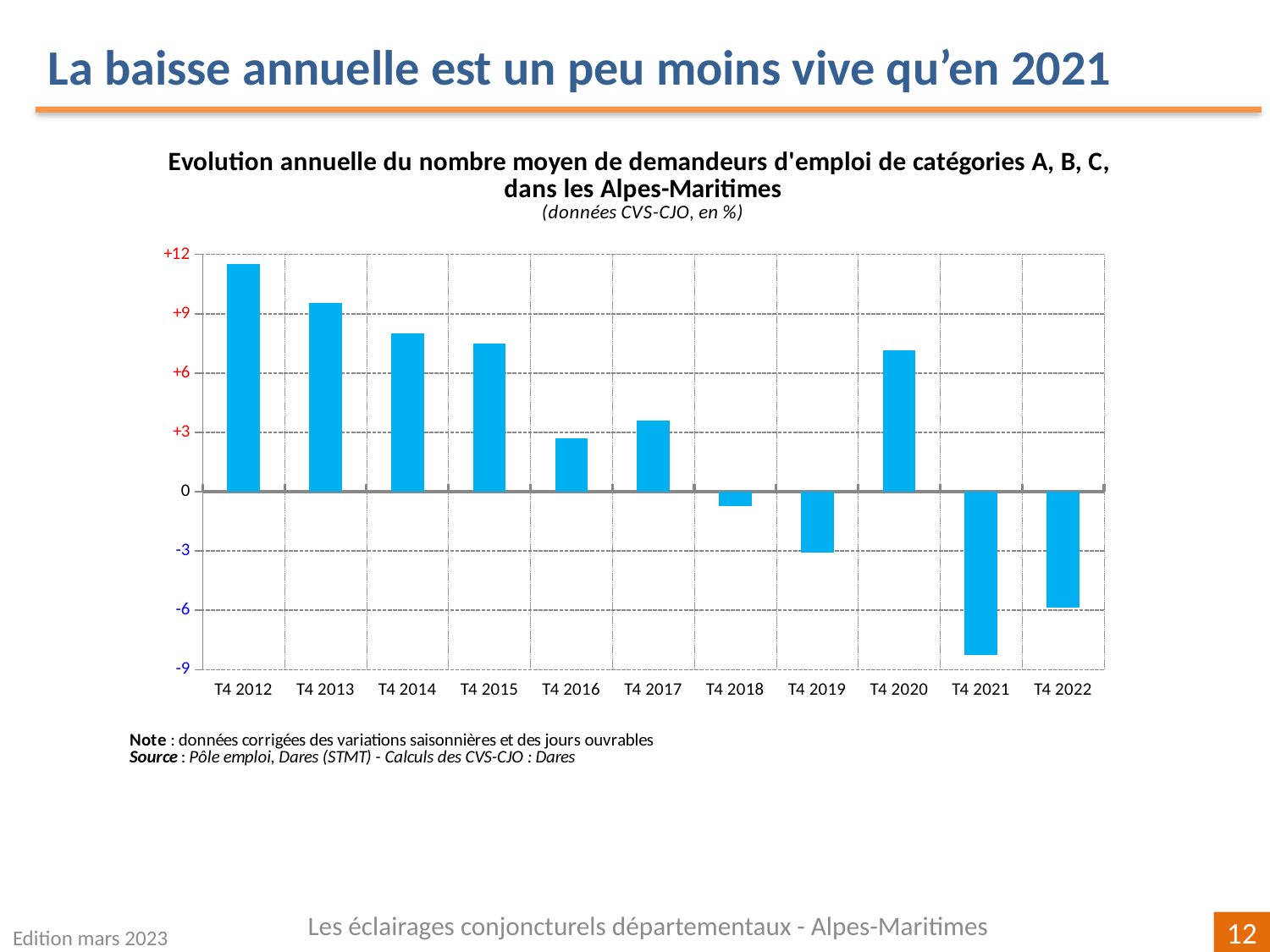
Is the value for T4 2021 less or greater than -6? less What kind of chart is shown on the slide? bar chart Which quarter has the highest value? T4 2012 Is the value for T4 2022 greater or less than -3? less Do the values rise or fall from T4 2012 to T4 2016? fall How many quarters (categories) are plotted on the x axis? 11 Which is larger, the value for T4 2021 or the value for T4 2022? T4 2022 Is the value for T4 2012 greater or less than +9? greater In what unit are the chart's data expressed, according to the subtitle? % Which quarter has the lowest value? T4 2021 Which is larger, the value for T4 2013 or the value for T4 2014? T4 2013